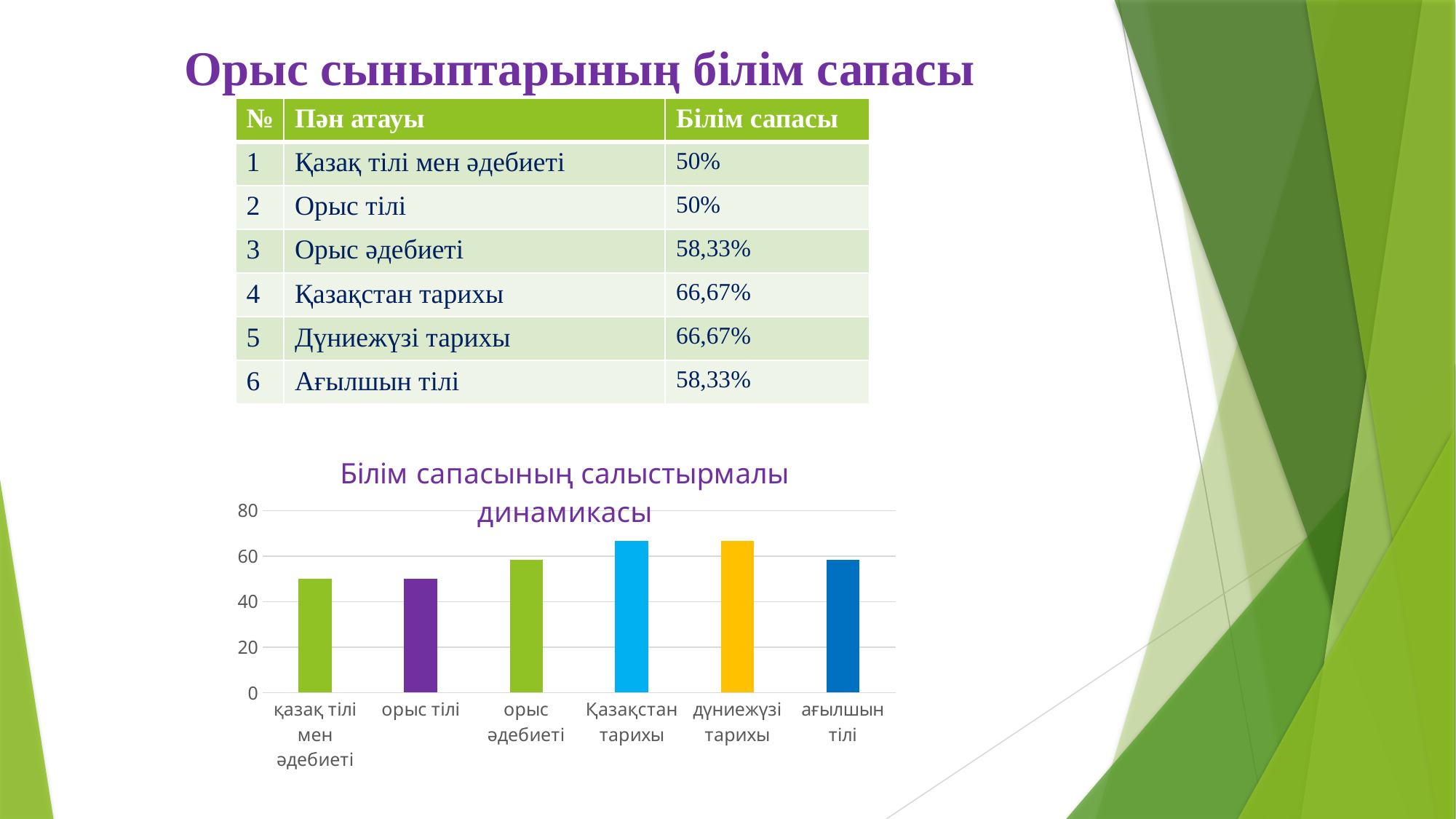
What is the title of the chart? Білім сапасының салыстырмалы динамикасы Is the value for орыс тілі greater or less than 60? less Which is larger, the value for Қазақстан тарихы or the value for орыс тілі? Қазақстан тарихы What colour is the bar for Қазақстан тарихы? light blue What is the difference between the value for Қазақстан тарихы and the value for орыс тілі? 16,67% Is the value for дүниежүзі тарихы greater or less than 60? greater What is the value for орыс әдебиеті? 58,33% What kind of chart is shown on the slide? bar chart What is the value for Қазақстан тарихы? 66,67% How many categories are plotted on the x axis of the chart? 6 What is the value for орыс тілі? 50% Is the value for ағылшын тілі greater or less than 40? greater